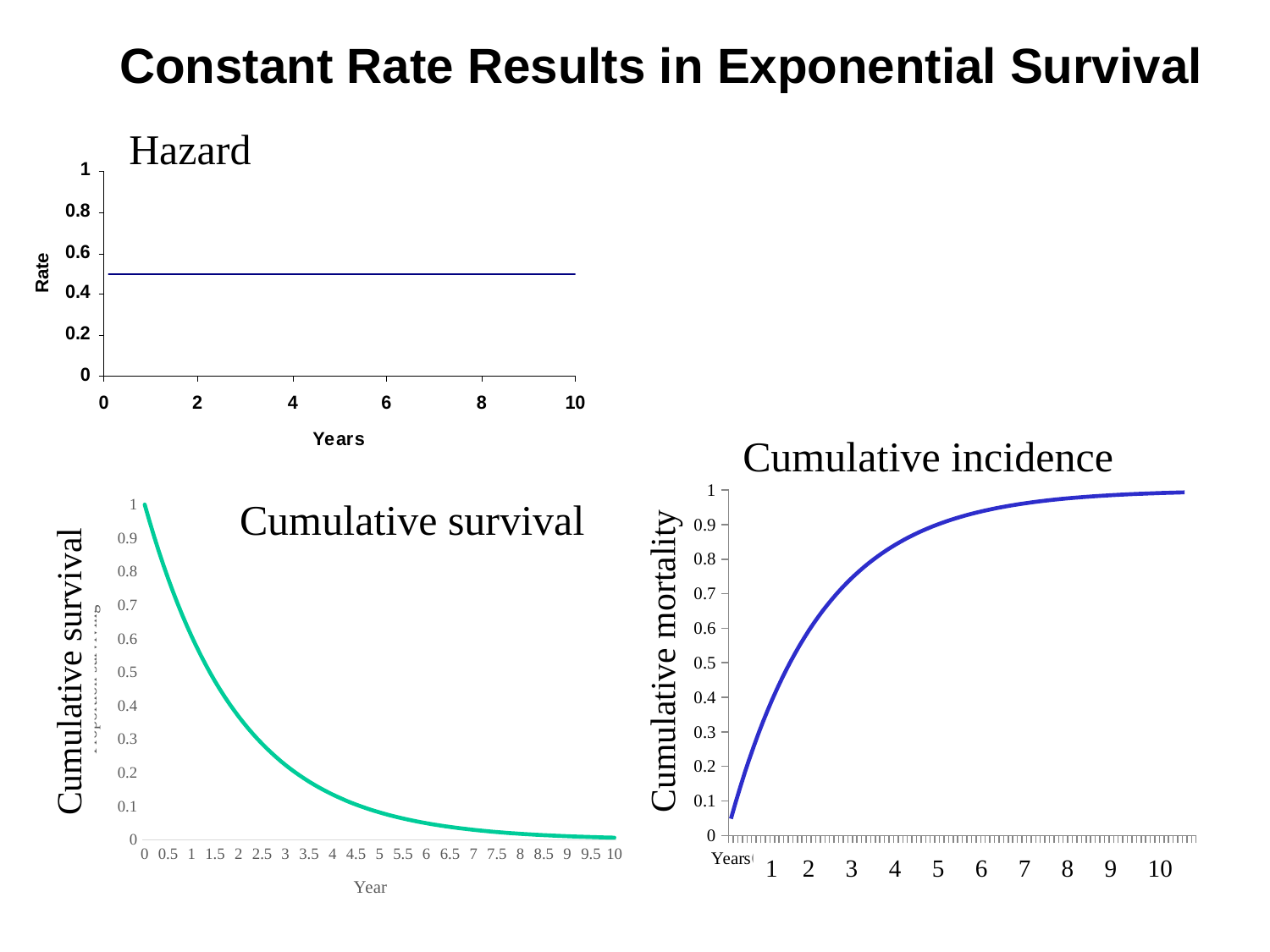
In the Cumulative survival chart, what is the cumulative survival at year 0? 1 In the Hazard chart, is the rate at year 8 greater or less than 0.6? less In the Hazard chart, does the rate rise, fall, or stay constant across the years? stays constant In the Hazard chart, is the rate at year 4 greater or less than 0.4? greater In the Cumulative survival chart, is the value at year 2 greater or less than 0.5? less What kind of chart is the Hazard chart? line chart In the Cumulative incidence chart, do the values rise or fall as the years increase? rise What is the y-axis label of the Hazard chart? Rate In the Cumulative survival chart, do the values rise or fall as the years increase? fall